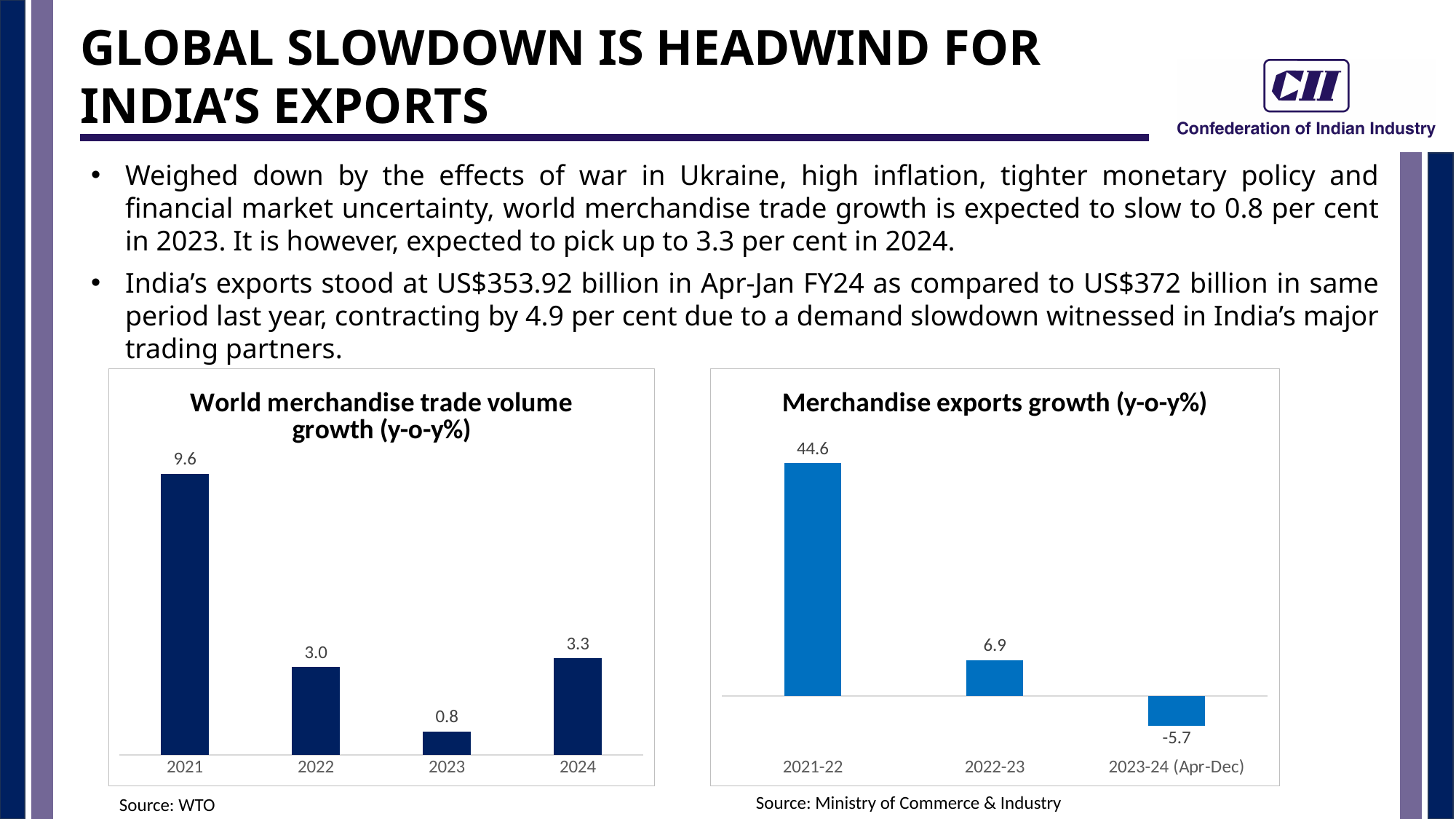
In the 'Merchandise exports growth (y-o-y%)' chart, do the values rise or fall from 2021-22 to 2023-24 (Apr-Dec)? fall In the 'World merchandise trade volume growth (y-o-y%)' chart, how many years are shown? 4 In the 'World merchandise trade volume growth (y-o-y%)' chart, which year has the highest value? 2021 In the 'Merchandise exports growth (y-o-y%)' chart, what is the difference between the values for 2021-22 and 2022-23? 37.7 In the 'World merchandise trade volume growth (y-o-y%)' chart, what is the value for 2021? 9.6 In the 'Merchandise exports growth (y-o-y%)' chart, what is the value for 2022-23? 6.9 What kind of chart is the 'Merchandise exports growth (y-o-y%)' chart? bar chart In the 'Merchandise exports growth (y-o-y%)' chart, which period has the highest value? 2021-22 In the 'World merchandise trade volume growth (y-o-y%)' chart, which year has the lowest value? 2023 In the 'Merchandise exports growth (y-o-y%)' chart, what is the value for 2023-24 (Apr-Dec)? -5.7 In the 'World merchandise trade volume growth (y-o-y%)' chart, what is the value for 2023? 0.8 In the 'World merchandise trade volume growth (y-o-y%)' chart, what is the difference between the values for 2024 and 2023? 2.5